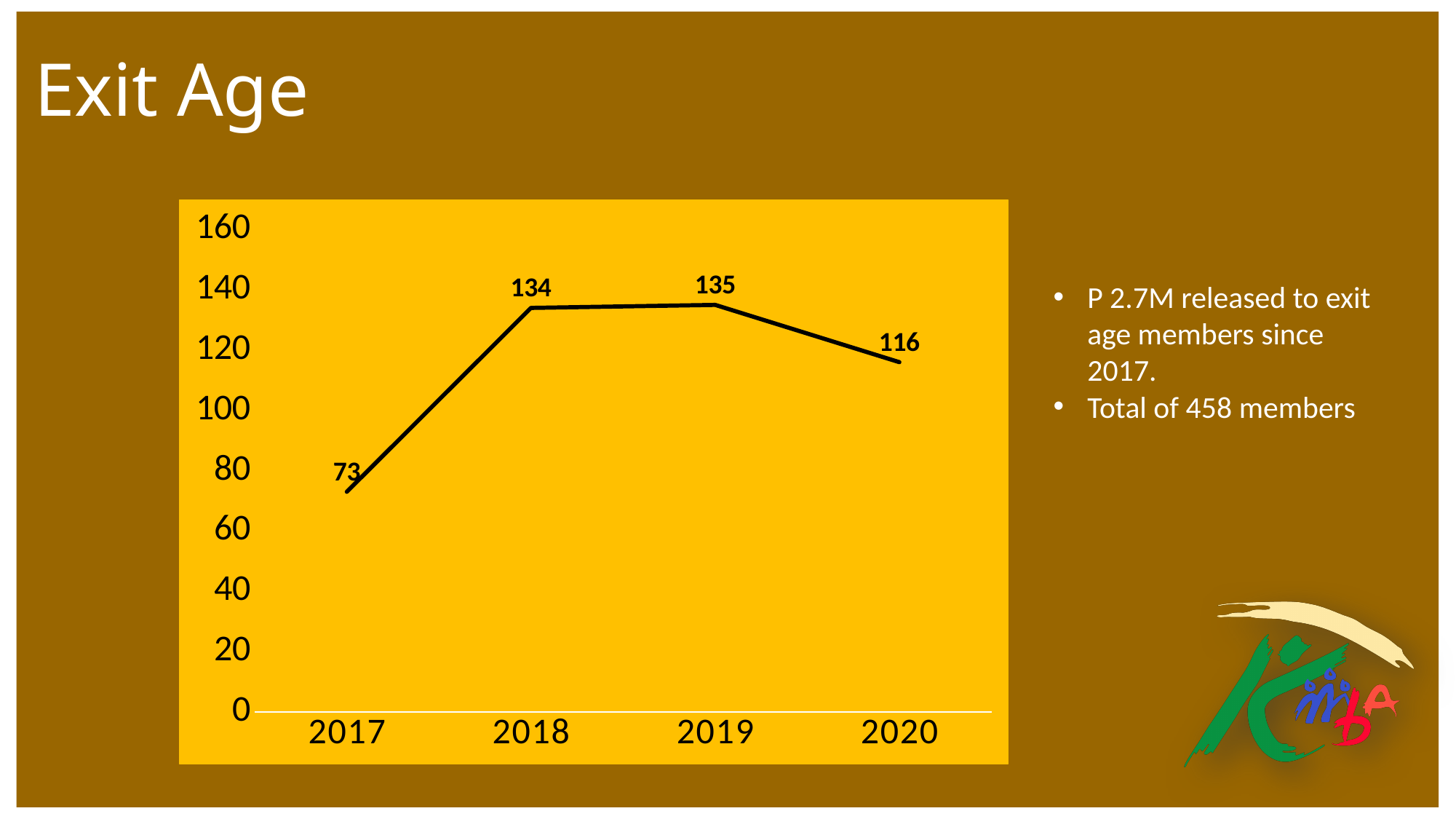
Is the value for 2020 greater or less than 100? greater What is the difference between the values for 2018 and 2017? 61 What is the value for 2020? 116 Which year has the lowest value? 2017 What is the value for 2017? 73 Which year has the highest value? 2019 Does the value rise or fall from 2019 to 2020? fall What is the difference between the values for 2019 and 2020? 19 How many years are plotted on the chart? 4 What kind of chart is shown on the slide? line chart Which is larger, the value for 2020 or the value for 2017? 2020 What is the value for 2018? 134